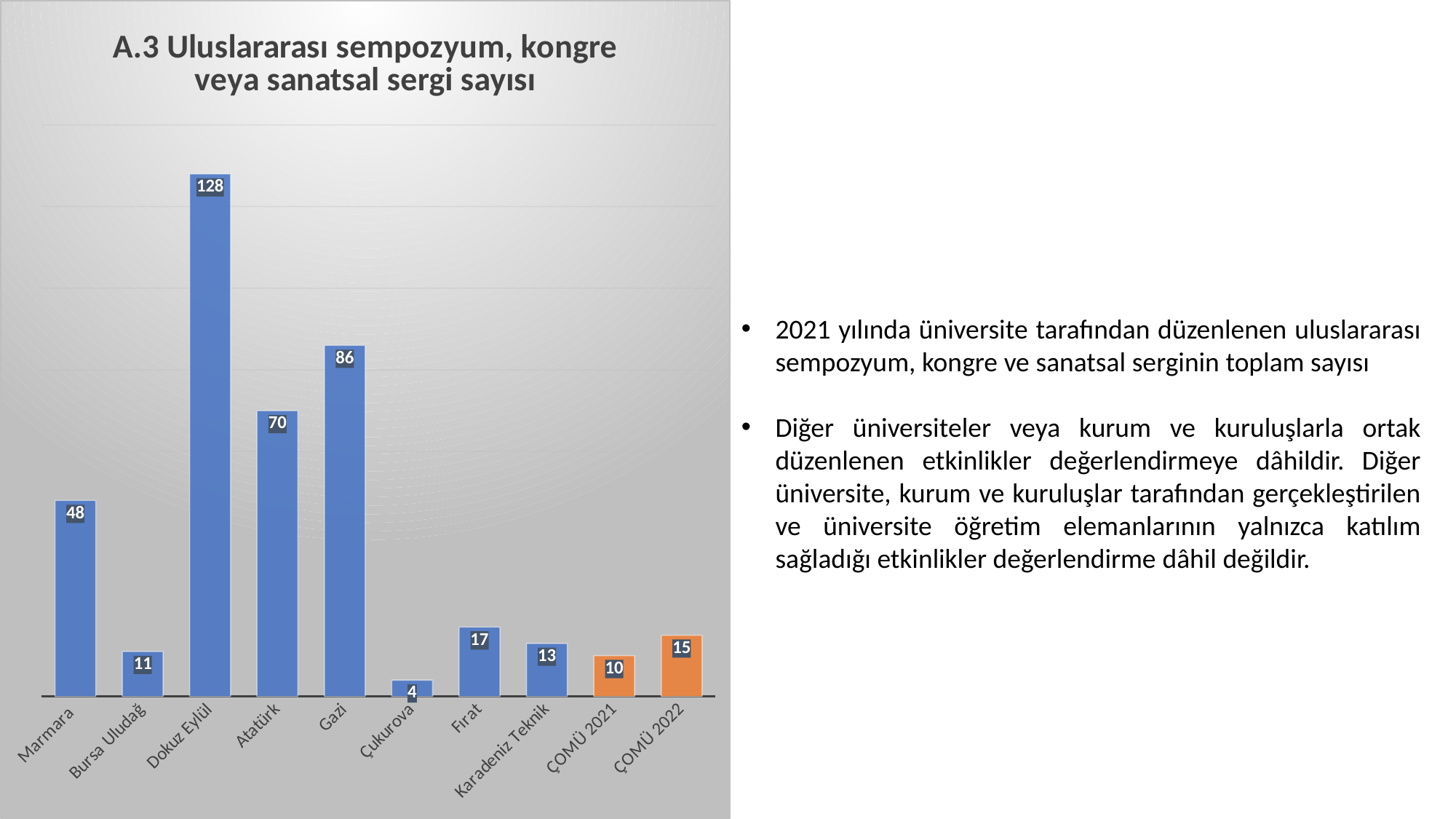
What is the difference between the values for ÇOMÜ 2022 and ÇOMÜ 2021? 5 Which is larger, the value for Marmara or the value for Bursa Uludağ? Marmara What is the value for ÇOMÜ 2022? 15 What is the value for Çukurova? 4 Which category has the lowest value? Çukurova What is the value for Dokuz Eylül? 128 What is the difference between the values for Gazi and Atatürk? 16 What kind of chart is shown on the slide? Bar chart Which category has the highest value? Dokuz Eylül What is the title of the chart? A.3 Uluslararası sempozyum, kongre veya sanatsal sergi sayısı How many categories are shown on the x axis? 10 Which is larger, the value for Fırat or the value for Karadeniz Teknik? Fırat